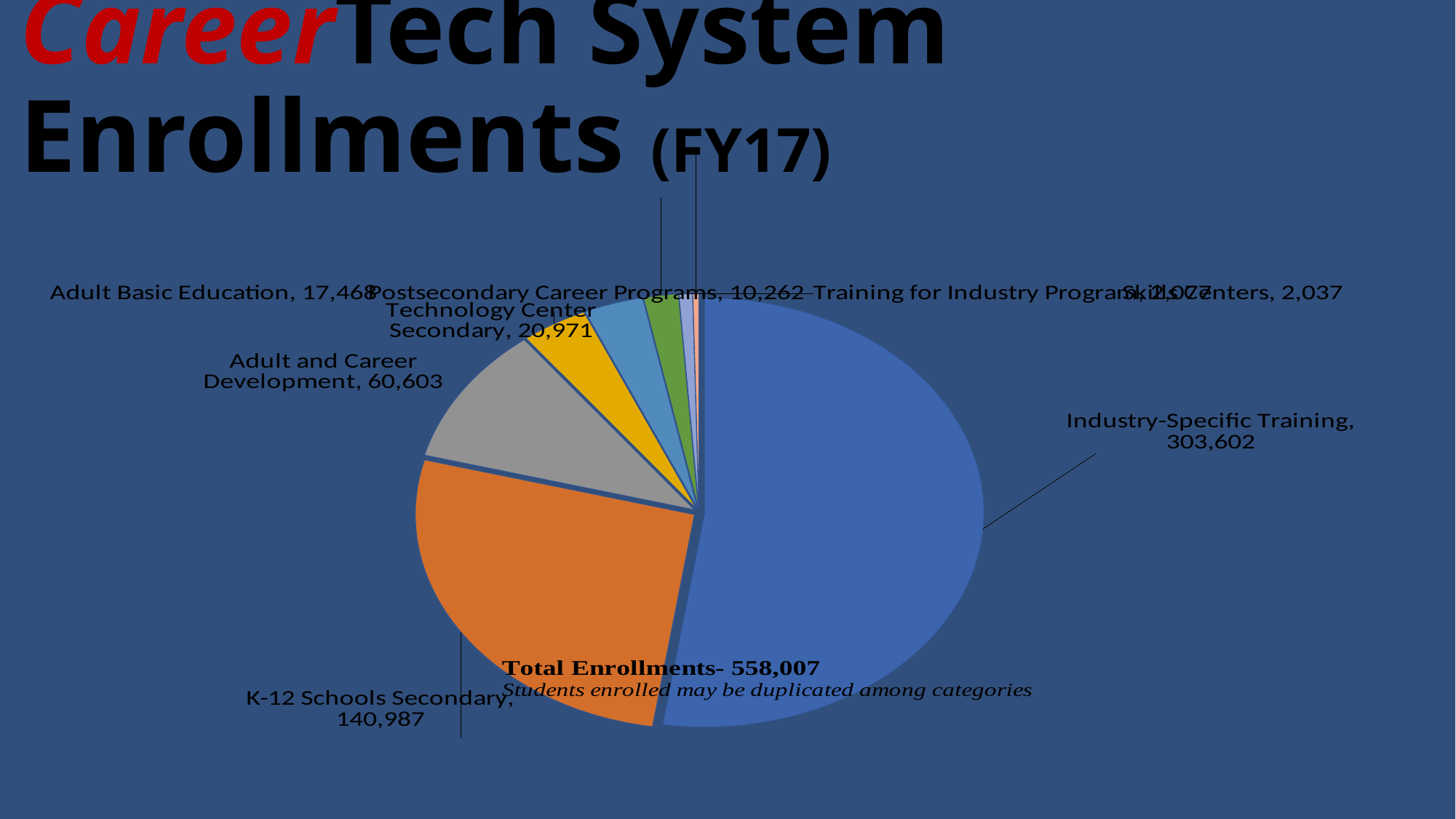
Which category has the largest slice of the pie? Industry-Specific Training How many slices does the pie chart have? 8 What is the enrollment value for Postsecondary Career Programs? 10,262 What fiscal year does the slide title say the enrollments are for? FY17 What is the enrollment value for Technology Center Secondary? 20,971 What is the difference in enrollments between Industry-Specific Training and K-12 Schools Secondary? 162,615 What is the enrollment value for Adult and Career Development? 60,603 What is the enrollment value for K-12 Schools Secondary? 140,987 What is the enrollment value for Industry-Specific Training? 303,602 What kind of chart is shown on the slide? pie chart Which has more enrollments, Adult Basic Education or Technology Center Secondary? Technology Center Secondary What total enrollment figure is printed on the chart? 558,007